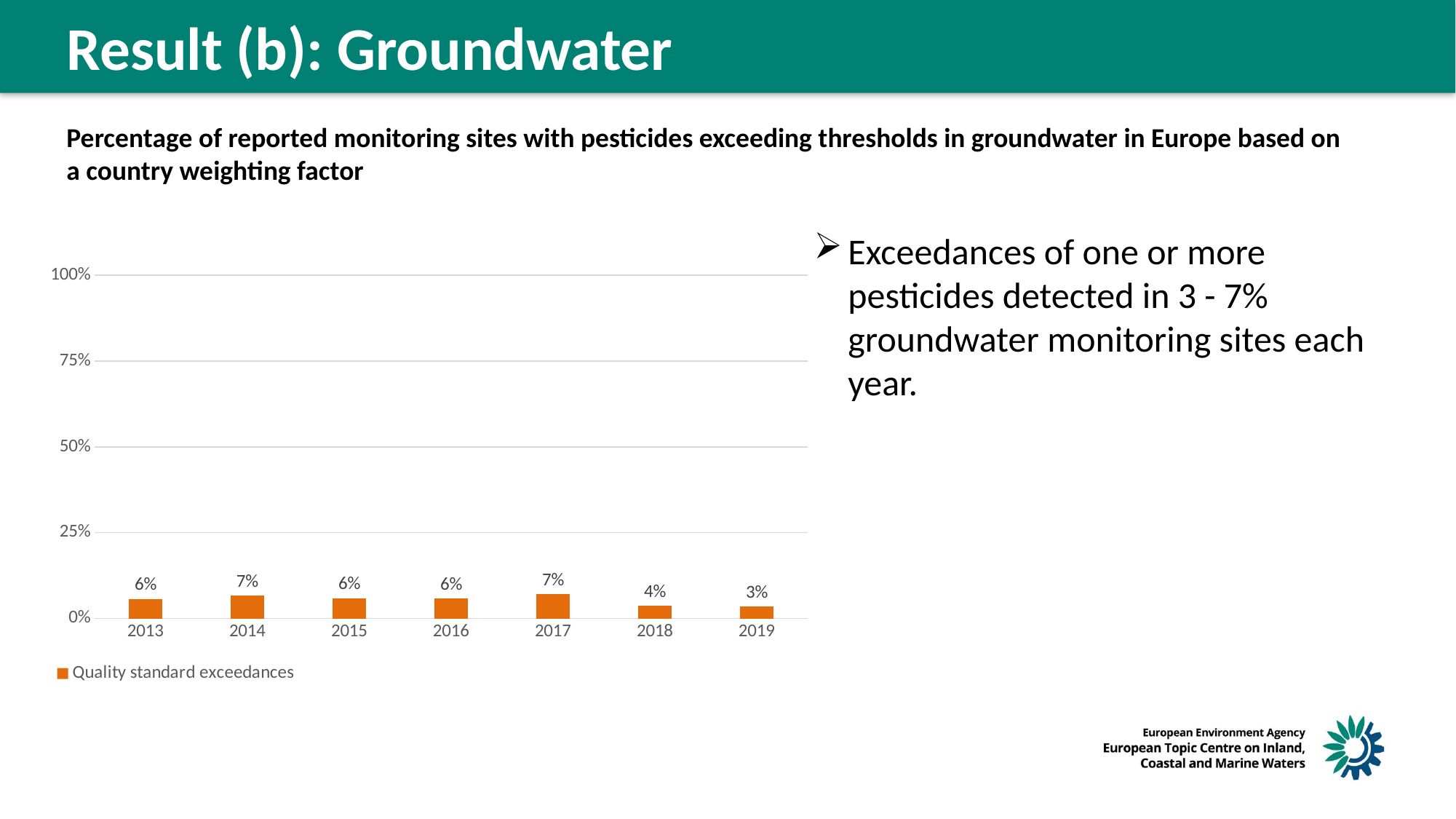
Is the value for 2017 greater or less than 25%? less What series name does the legend show? Quality standard exceedances What is the difference between the values for 2017 and 2019? 4% What is the value for 2018? 4% Which is larger, the value for 2014 or the value for 2018? 2014 Which year has the lowest value? 2019 What is the value for 2017? 7% What is the difference between the values for 2014 and 2018? 3% How many years are shown on the x axis? 7 What is the value for 2013? 6% What kind of chart is shown on the slide? bar chart What is the value for 2019? 3%